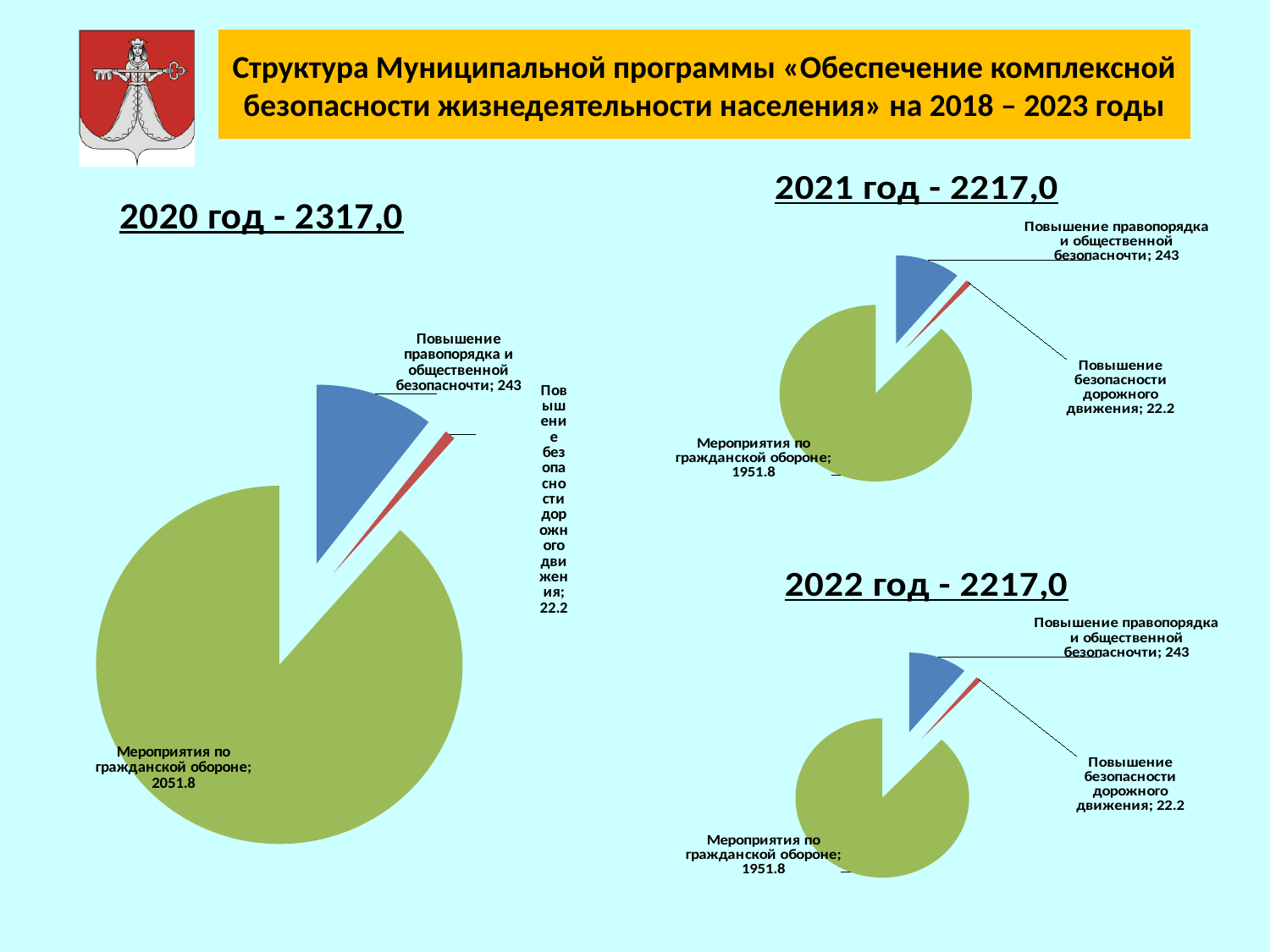
In the 2022 год - 2217,0 chart, which category has the smallest slice? Повышение безопасности дорожного движения What colour is the Мероприятия по гражданской обороне slice in the 2021 год - 2217,0 chart? green In the 2021 год - 2217,0 chart, what is the value for Мероприятия по гражданской обороне? 1951.8 In the 2022 год - 2217,0 chart, what is the difference between Повышение правопорядка и общественной безопасночти and Повышение безопасности дорожного движения? 220.8 In the 2022 год - 2217,0 chart, what is the value for Повышение безопасности дорожного движения? 22.2 In the 2020 год - 2317,0 chart, what is the value for Мероприятия по гражданской обороне? 2051.8 In the 2021 год - 2217,0 chart, what is the value for Повышение правопорядка и общественной безопасночти? 243 In the 2020 год - 2317,0 chart, which category has the largest slice? Мероприятия по гражданской обороне What kind of chart is used for the 2020 год - 2317,0 chart? pie chart How many slices does the 2021 год - 2217,0 pie chart have? 3 What is the difference between the Мероприятия по гражданской обороне value in the 2020 год - 2317,0 chart and the same category in the 2021 год - 2217,0 chart? 100 In the 2020 год - 2317,0 chart, which is larger: Повышение правопорядка и общественной безопасночти or Повышение безопасности дорожного движения? Повышение правопорядка и общественной безопасночти